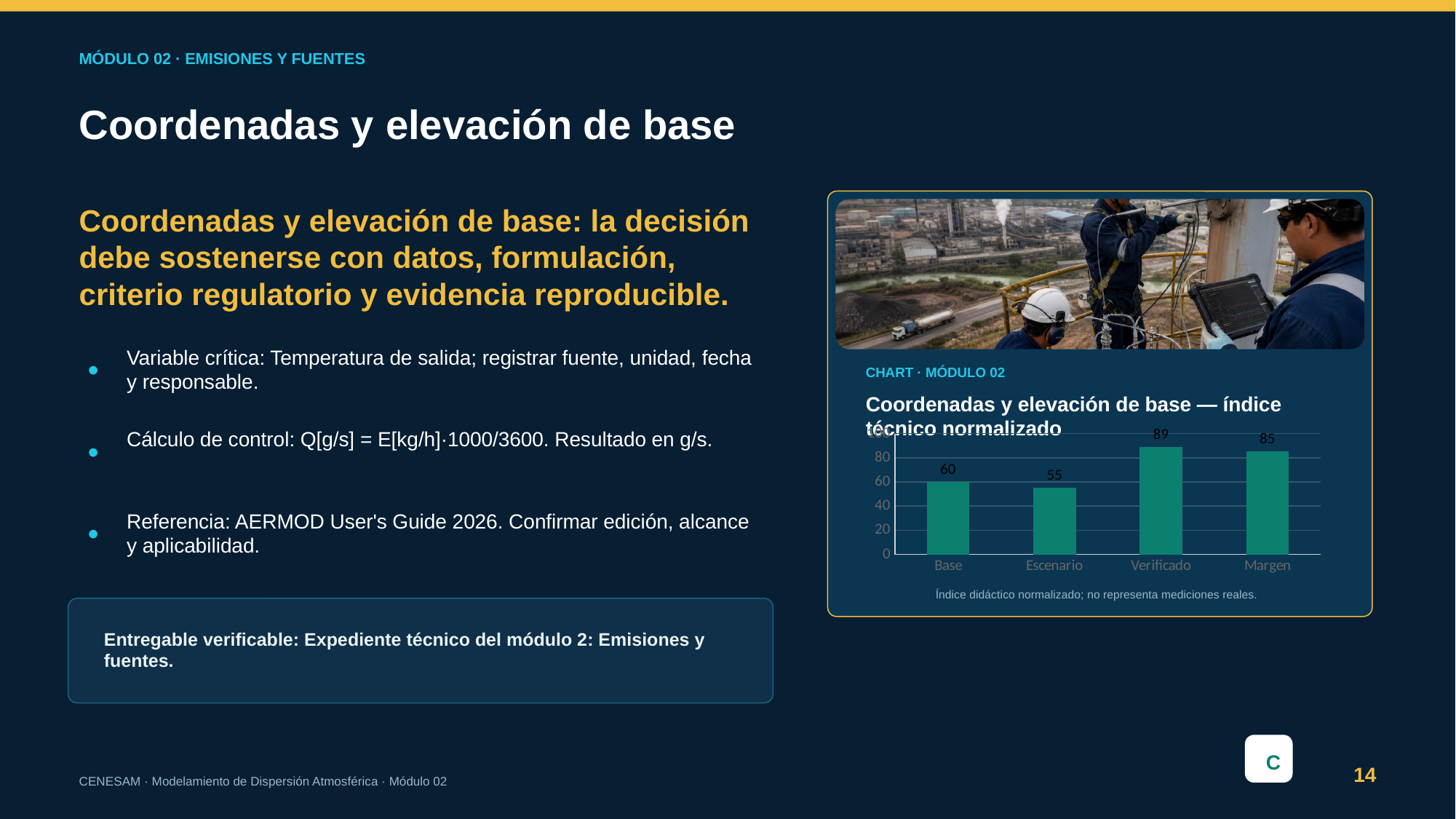
What is the difference between the values for Margen and Escenario? 30 What is the title of the chart? Coordenadas y elevación de base — índice técnico normalizado Which category has the lowest value? Escenario What is the difference between the values for Verificado and Base? 29 What kind of chart is shown? Bar chart Which category has the highest value? Verificado What is the value for Margen? 85 What is the value for Escenario? 55 What is the value for Base? 60 Which is larger, the value for Base or the value for Escenario? Base How many categories are shown on the x axis? 4 What is the value for Verificado? 89